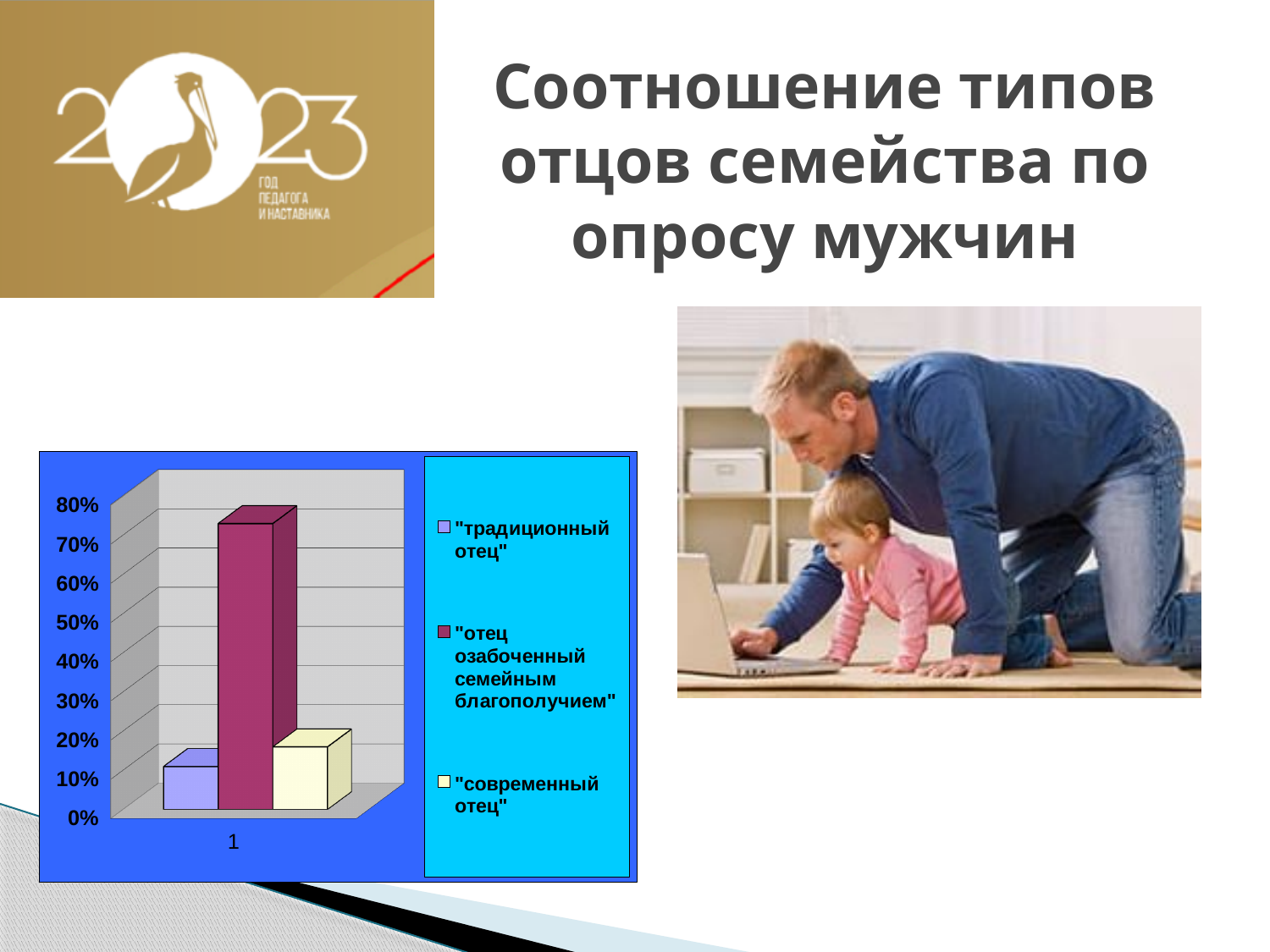
How many categories are shown on the x axis of the chart? 1 Which is larger, the value for "современный отец" or the value for "традиционный отец"? "современный отец" Is the value for "отец озабоченный семейным благополучием" greater or less than 60%? greater Which series has the highest bar in the chart? "отец озабоченный семейным благополучием" Is the value for "современный отец" greater or less than 30%? less What colour is the bar for "современный отец" in the chart? light yellow Is the value for "традиционный отец" greater or less than 20%? less What kind of chart is shown on the slide? bar chart What is the highest value shown on the chart's vertical axis? 80% Which series has the lowest bar in the chart? "традиционный отец" How many series does the chart legend list? 3